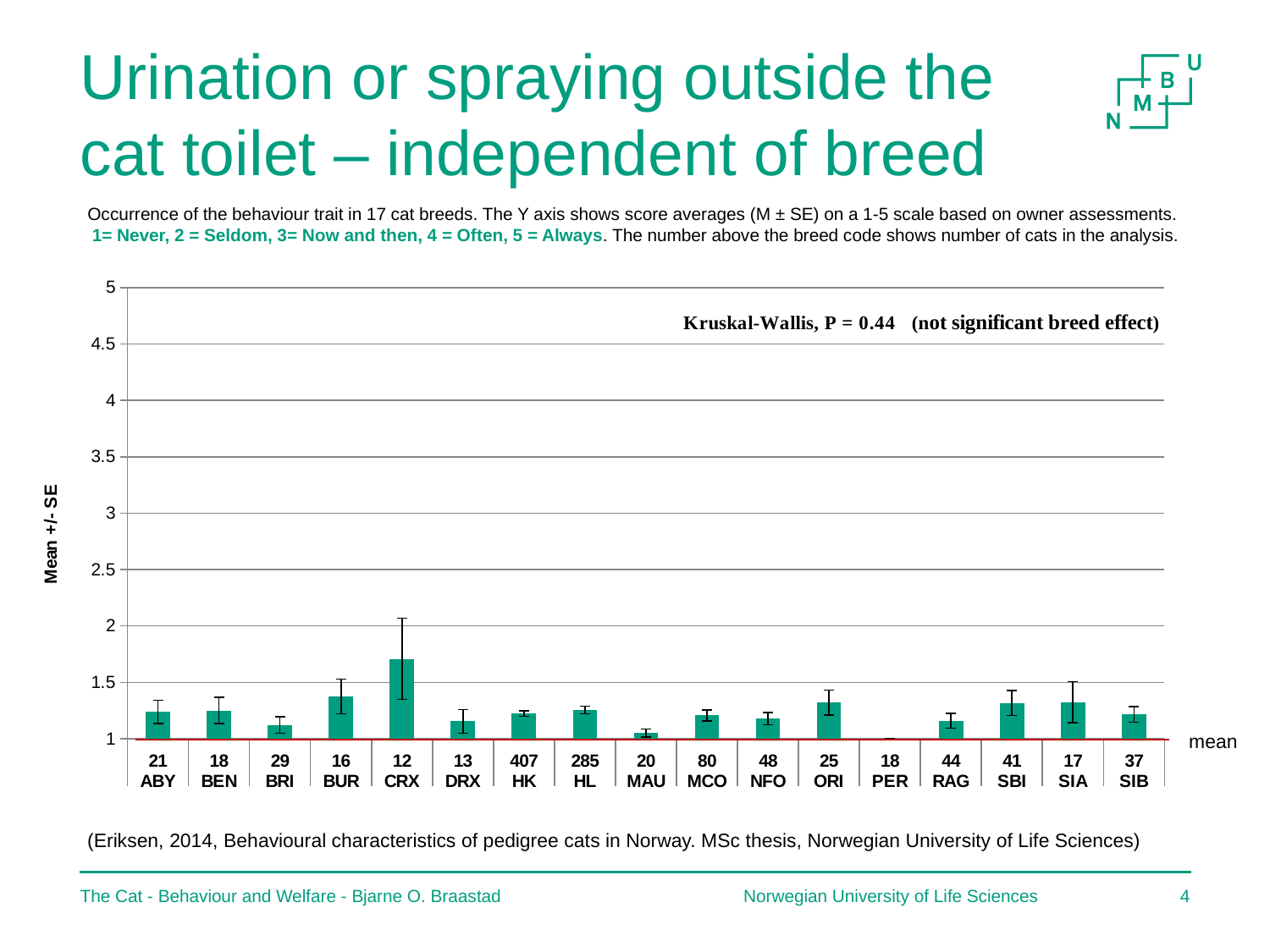
Is the mean value for CRX greater or less than 1.5? greater Which breed has the larger mean score, CRX or BUR? CRX How many cats of breed HK were included in the analysis, according to the number above the breed code? 407 Which breed has the larger mean score, ORI or BRI? ORI Which breed has the highest mean score for urination or spraying outside the cat toilet? CRX How many cats of breed HL were included in the analysis? 285 Which breed has the lowest mean score in the chart? PER What P value is reported for the Kruskal-Wallis test on the chart? 0.44 What kind of chart is shown on the slide? bar chart How many cat breeds are shown along the x axis of the chart? 17 Is the mean value for BUR greater or less than 1.5? less Is the mean value for ABY greater or less than 2? less